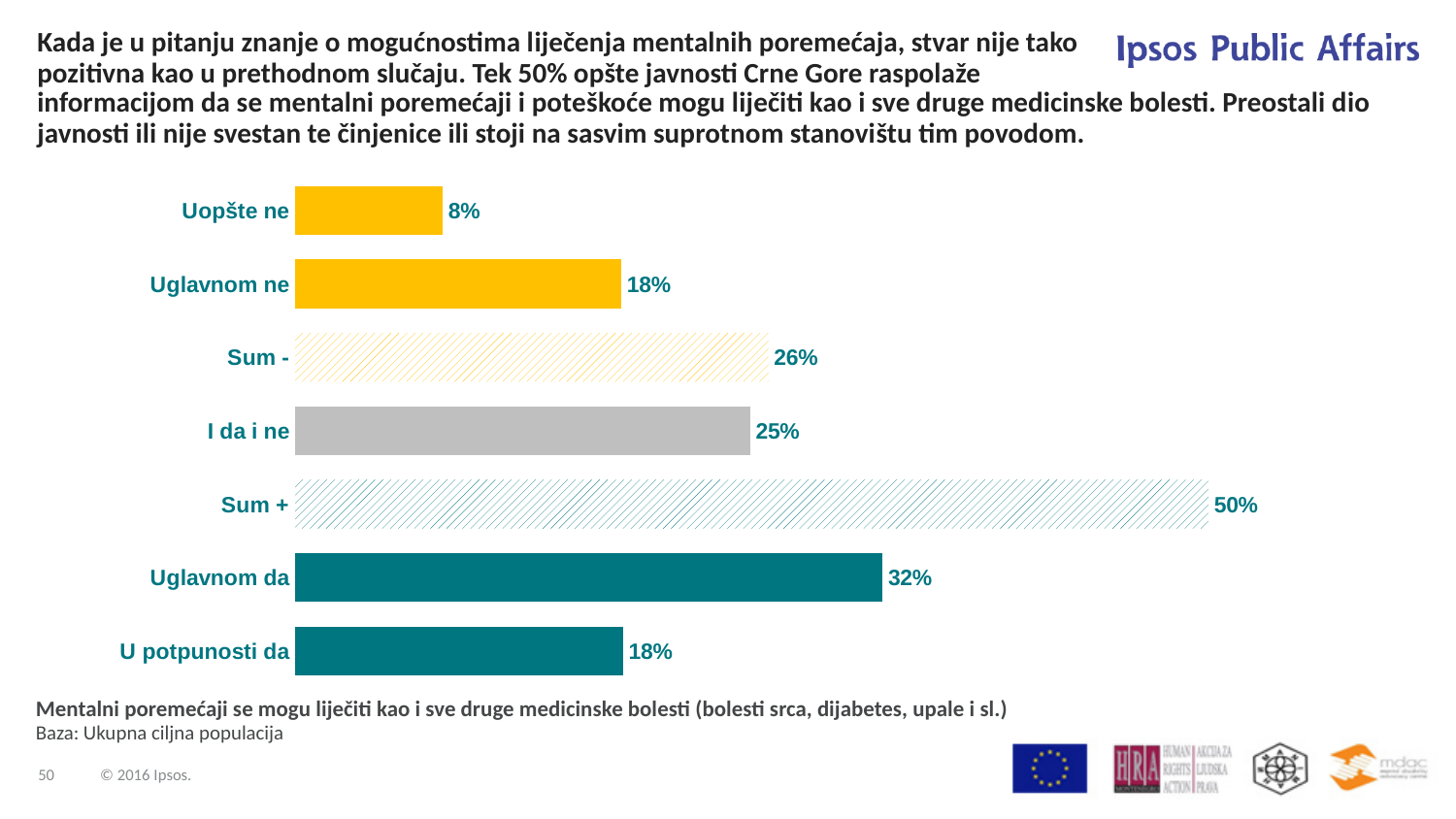
What is the value for "Uopšte ne"? 8% What is the difference between "Sum +" and "Sum -"? 24% What is the value for "Sum -"? 26% How many categories are shown in the chart? 7 Which category has the lowest value? Uopšte ne What is the value for "Uglavnom da"? 32% What is the value for "Sum +"? 50% Which is larger, "Uglavnom da" or "U potpunosti da"? Uglavnom da What kind of chart is shown on the slide? Bar chart What is the difference between "Uglavnom da" and "Uglavnom ne"? 14% What is the value for "I da i ne"? 25% Which category has the highest value? Sum +